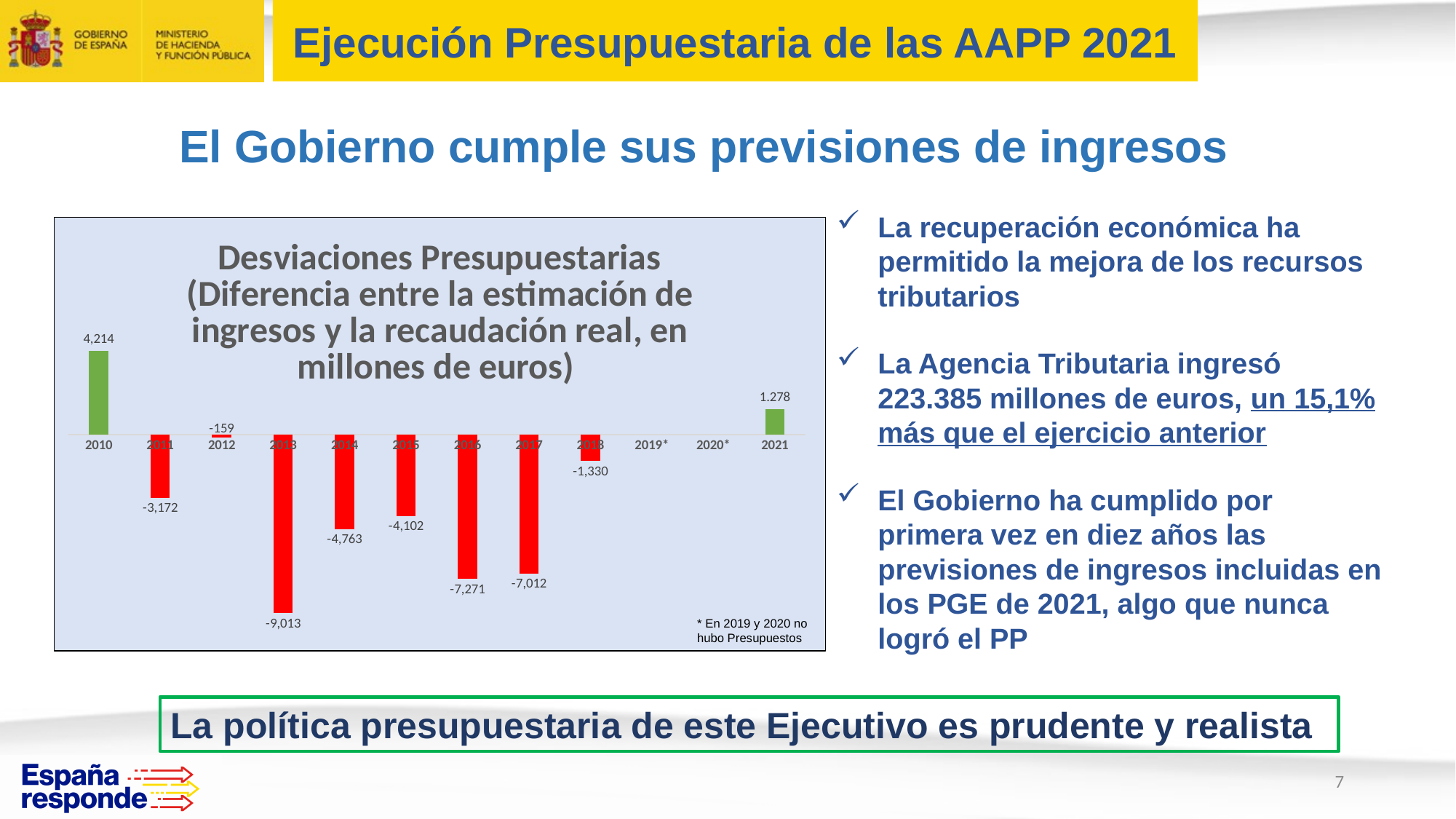
What is the value shown for 2013 in the Desviaciones Presupuestarias chart? -9,013 Which year has the lowest (most negative) value in the Desviaciones Presupuestarias chart? 2013 What kind of chart is the Desviaciones Presupuestarias chart? Bar chart What colour are the bars with positive values in the Desviaciones Presupuestarias chart? Green What is the value shown for 2010 in the Desviaciones Presupuestarias chart? 4,214 How many year labels are shown on the x axis of the Desviaciones Presupuestarias chart? 12 Which years in the Desviaciones Presupuestarias chart have no bar plotted? 2019 and 2020 What is the difference between the values for 2016 and 2017 in the Desviaciones Presupuestarias chart? 259 What is the value shown for 2021 in the Desviaciones Presupuestarias chart? 1.278 Which is larger in the Desviaciones Presupuestarias chart, the value for 2014 or the value for 2015? 2015 Which year has the highest value in the Desviaciones Presupuestarias chart? 2010 What is the value shown for 2018 in the Desviaciones Presupuestarias chart? -1,330